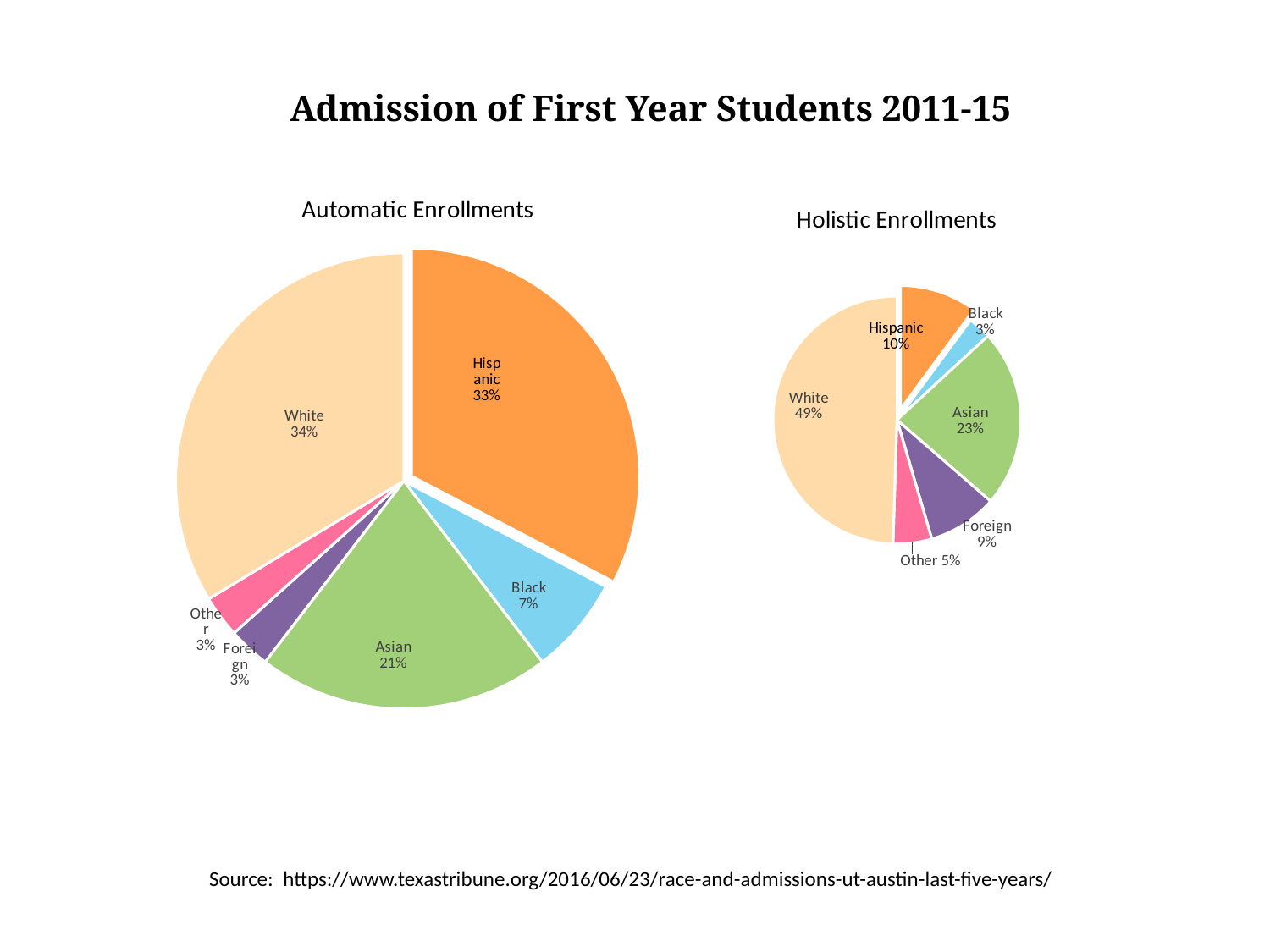
In the Automatic Enrollments chart, which category has the largest share? White In the Holistic Enrollments chart, what share is White? 49% In the Automatic Enrollments chart, which is larger, the Asian share or the Black share? Asian What is the difference between the White share in the Holistic Enrollments chart and the White share in the Automatic Enrollments chart? 15% In the Holistic Enrollments chart, which category has the smallest share? Black What kind of chart is the Automatic Enrollments chart? Pie chart How many categories does the Holistic Enrollments chart show? 6 In the Automatic Enrollments chart, what share is Black? 7% In the Holistic Enrollments chart, what share is Asian? 23% What is the title of the slide? Admission of First Year Students 2011-15 In the Automatic Enrollments chart, what share is Hispanic? 33% In the Holistic Enrollments chart, which category has the largest share? White